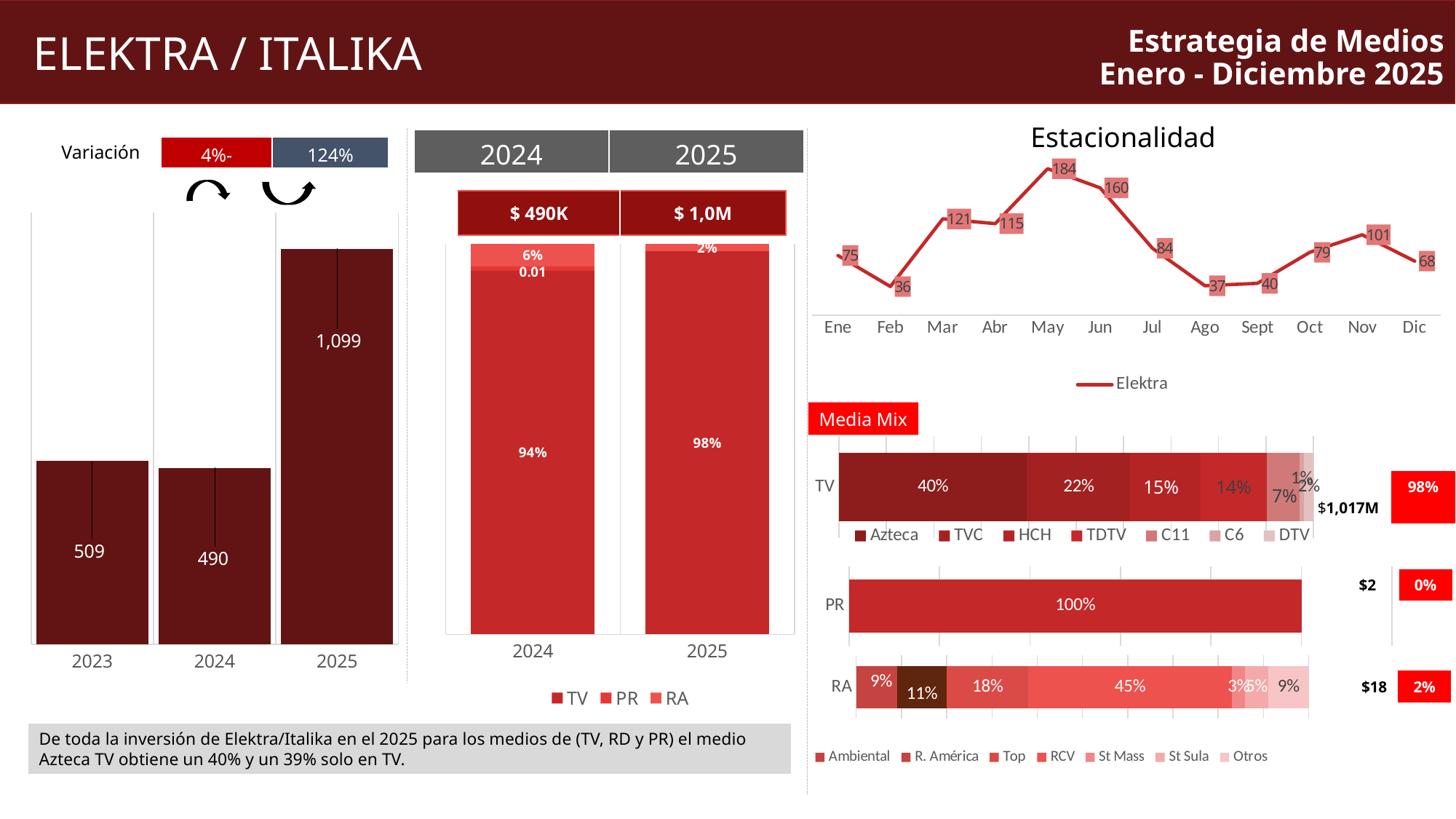
In the Estacionalidad line chart, how many months are plotted on the x axis? 12 In the bar chart on the left, what is the value for 2023? 509 In the bar chart on the left, what is the difference between the 2025 value and the 2024 value? 609 In the Estacionalidad line chart, which month has the highest value? May In the bar chart on the left, what is the value for 2025? 1,099 In the Estacionalidad line chart, do the values rise or fall from May to Ago? fall In the stacked bar chart for 2024 and 2025, what share does TV have in 2025? 98% In the bar chart on the left, which year has the lowest value? 2024 In the Estacionalidad line chart, what is the value for Nov? 101 In the Media Mix chart, what share does Azteca have in the TV bar? 40% In the Estacionalidad line chart, which month has the lowest value? Feb In the stacked bar chart for 2024 and 2025, how many series does the legend list? 3